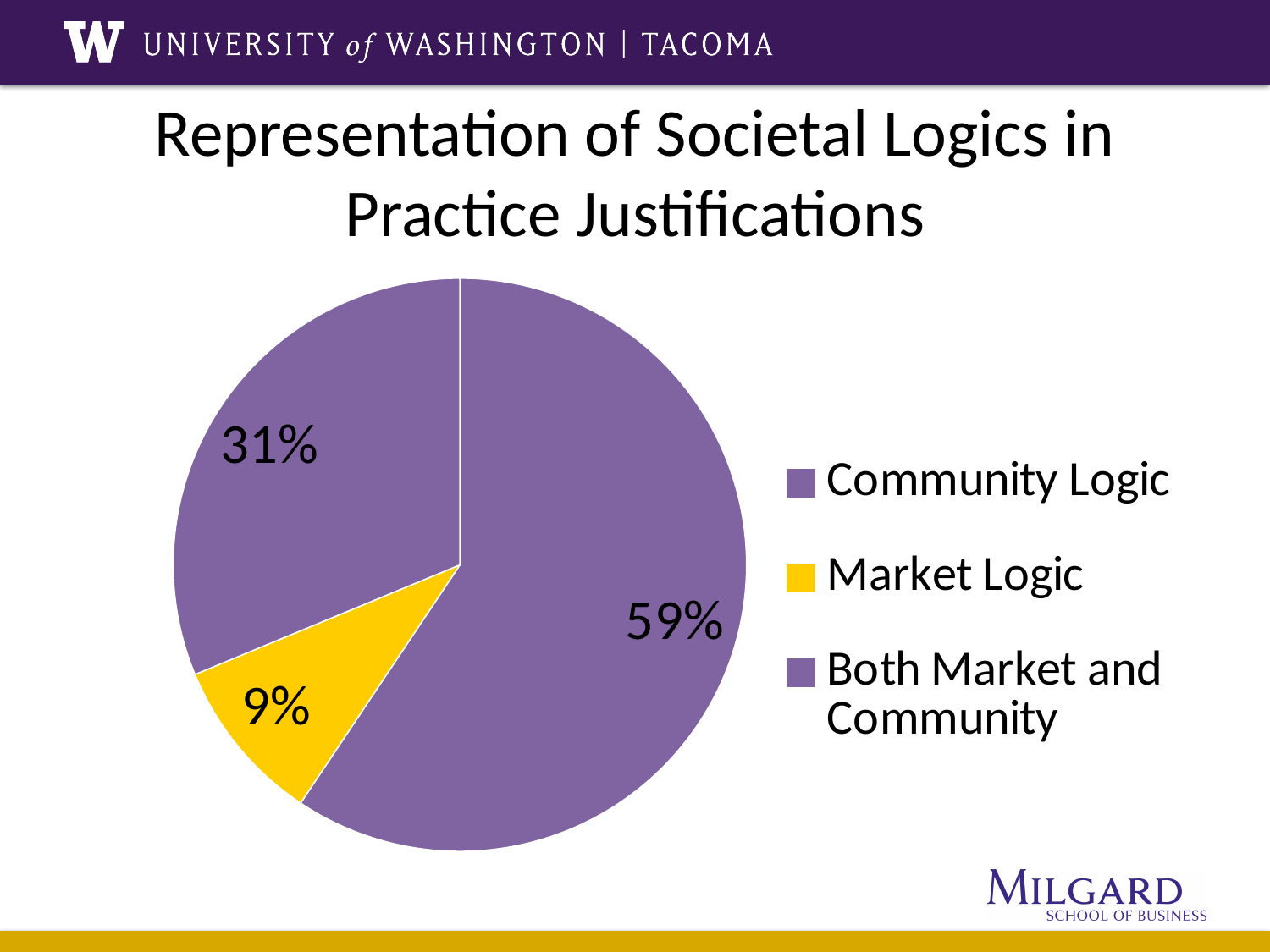
What is the value of the smallest slice in the pie chart? 9% What share of the pie does Market Logic represent? 9% Is the 31% slice larger or smaller than the Market Logic slice? larger What kind of chart is shown on the slide? pie chart What is the difference between the 31% slice and the Market Logic slice? 22% What colour is the Market Logic slice? yellow How many categories does the legend list? 3 How many slices does the pie chart have? 3 What is the title of the chart? Representation of Societal Logics in Practice Justifications What is the difference between the largest slice (59%) and the Market Logic slice? 50% What is the value of the largest slice in the pie chart? 59% Which category has the smallest slice of the pie? Market Logic